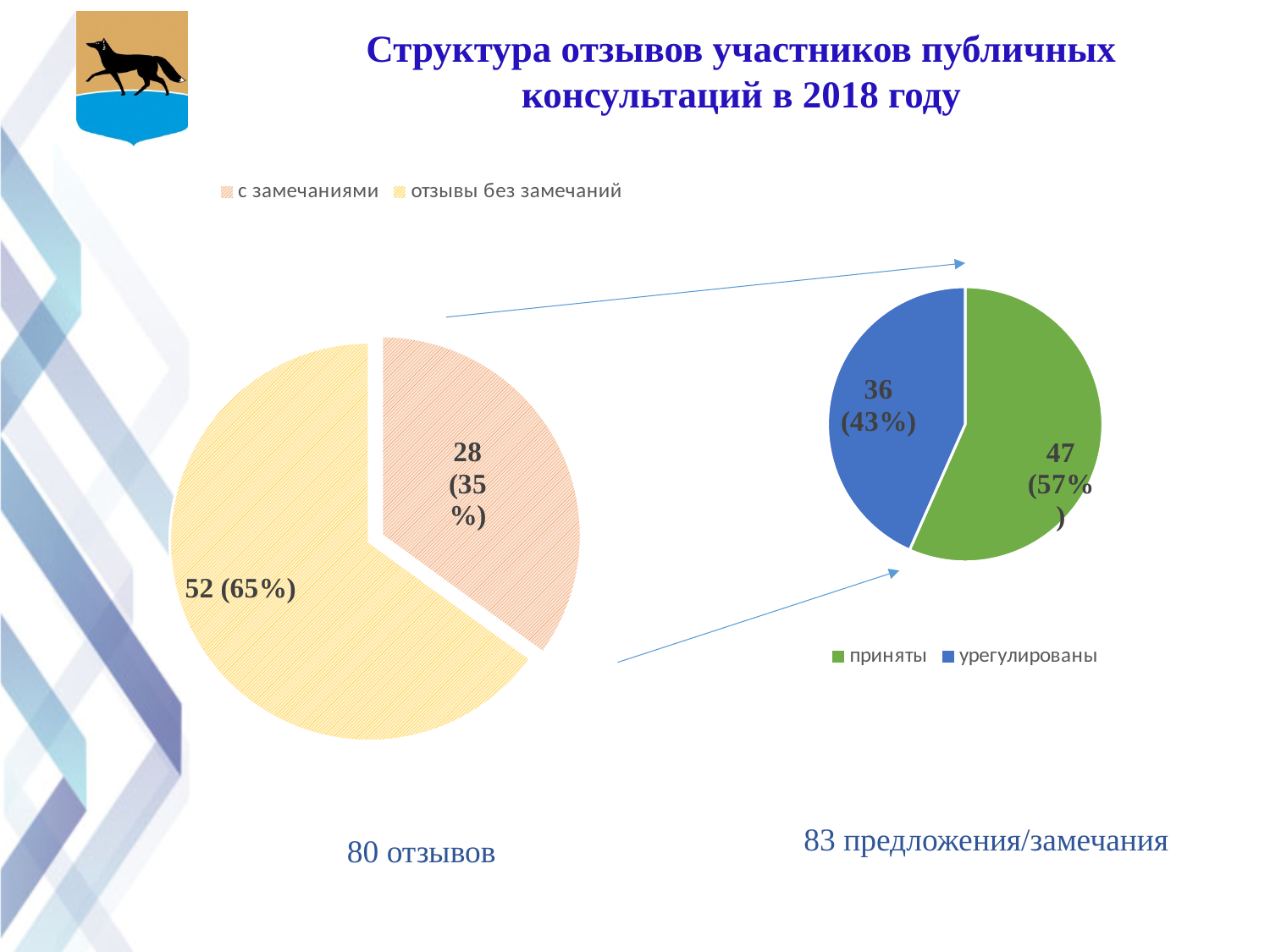
On the right pie chart, which slice is the smallest? урегулированы On the left pie chart, what is the difference between the 'отзывы без замечаний' and 'с замечаниями' counts? 24 What type of chart is shown on the left side of the slide? Pie chart On the right pie chart, what is the difference between the 'приняты' and 'урегулированы' counts? 11 On the left pie chart, what share of the pie does the 'отзывы без замечаний' slice represent? 65% On the right pie chart, which is larger: 'приняты' or 'урегулированы'? приняты On the left pie chart, what value is shown for the slice 'отзывы без замечаний'? 52 (65%) On the right pie chart, what value is shown for the slice 'приняты'? 47 (57%) On the left pie chart, which slice is the largest? отзывы без замечаний On the left pie chart, what value is shown for the slice 'с замечаниями'? 28 (35%) How many entries does the legend of the right pie chart list? 2 On the right pie chart, what value is shown for the slice 'урегулированы'? 36 (43%)